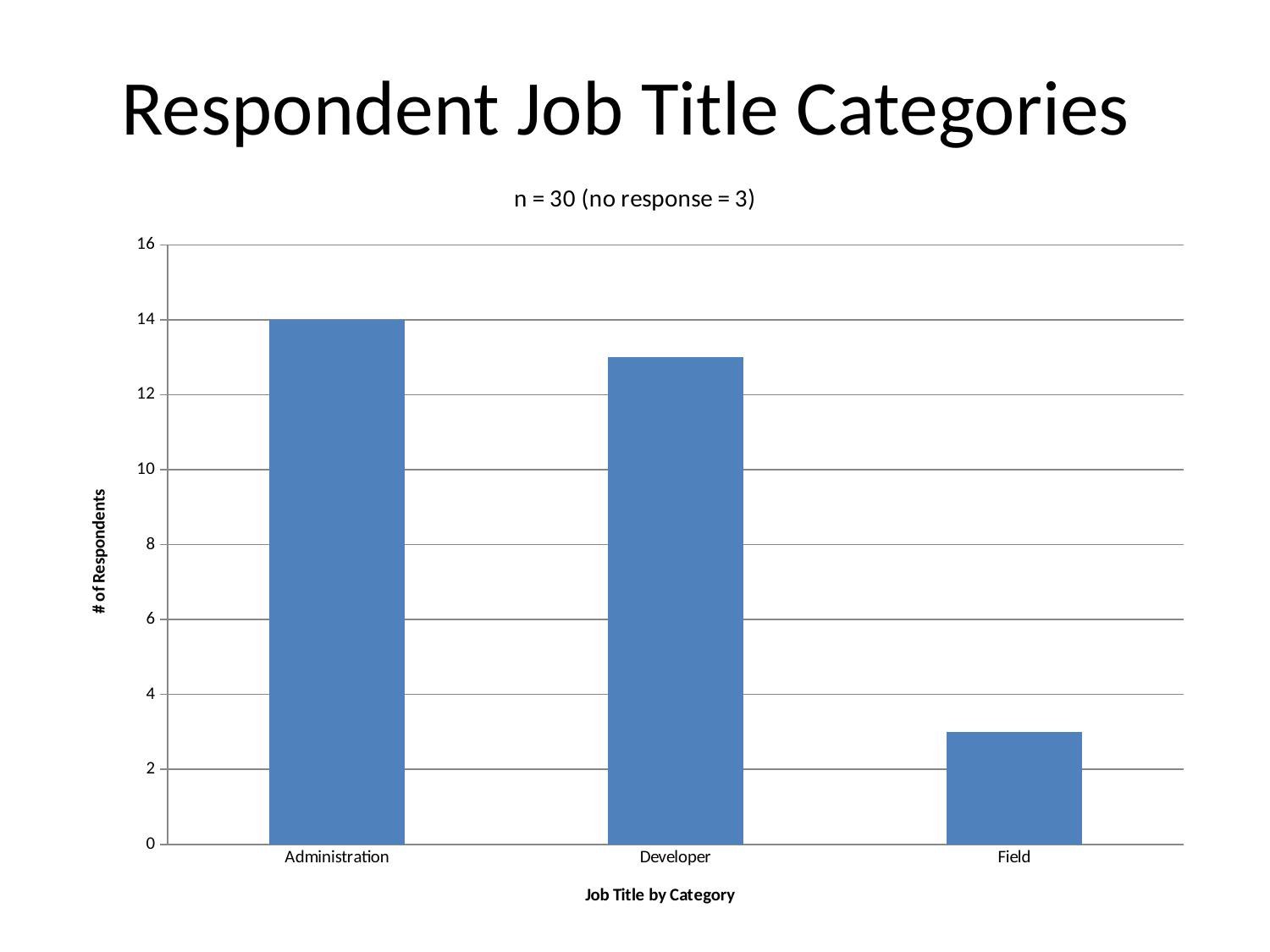
How many job title categories are plotted on the chart? 3 Which has more respondents, Developer or Field? Developer Which has more respondents, Administration or Developer? Administration Which job title category has the highest number of respondents? Administration Which job title category has the lowest number of respondents? Field Is the value for Field greater or less than 4? less What is the title of the chart's vertical axis? # of Respondents What is the chart's title? n = 30 (no response = 3) What is the number of respondents for Administration? 14 What kind of chart is shown on the slide? bar chart Is the value for Developer greater or less than 12? greater Is the value for Field greater or less than 2? greater